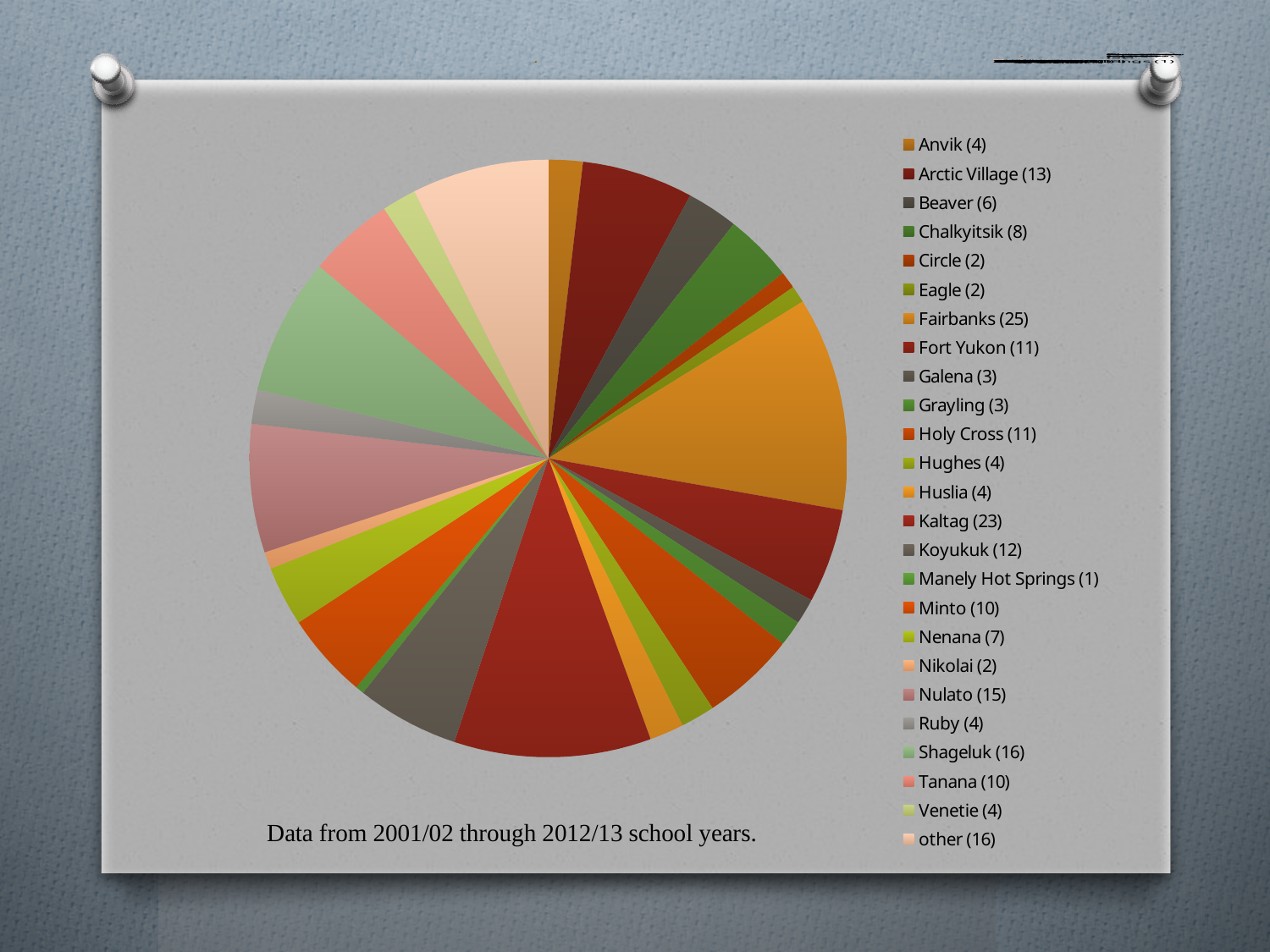
What is the value shown for Shageluk in the legend? 16 How many categories does the pie chart's legend list? 25 Which category has the largest value in the pie chart? Fairbanks What kind of chart is shown on the slide? pie chart Which has the larger value, Nulato or Arctic Village? Nulato What school years does the caption below the chart say the data covers? 2001/02 through 2012/13 What is the difference between the values for Koyukuk and Beaver? 6 Which category has the smallest value in the pie chart? Manely Hot Springs What is the difference between the values for Fairbanks and Kaltag? 2 What is the value shown for Kaltag in the legend? 23 What is the value shown for Manely Hot Springs in the legend? 1 What is the value shown for Fairbanks in the legend? 25